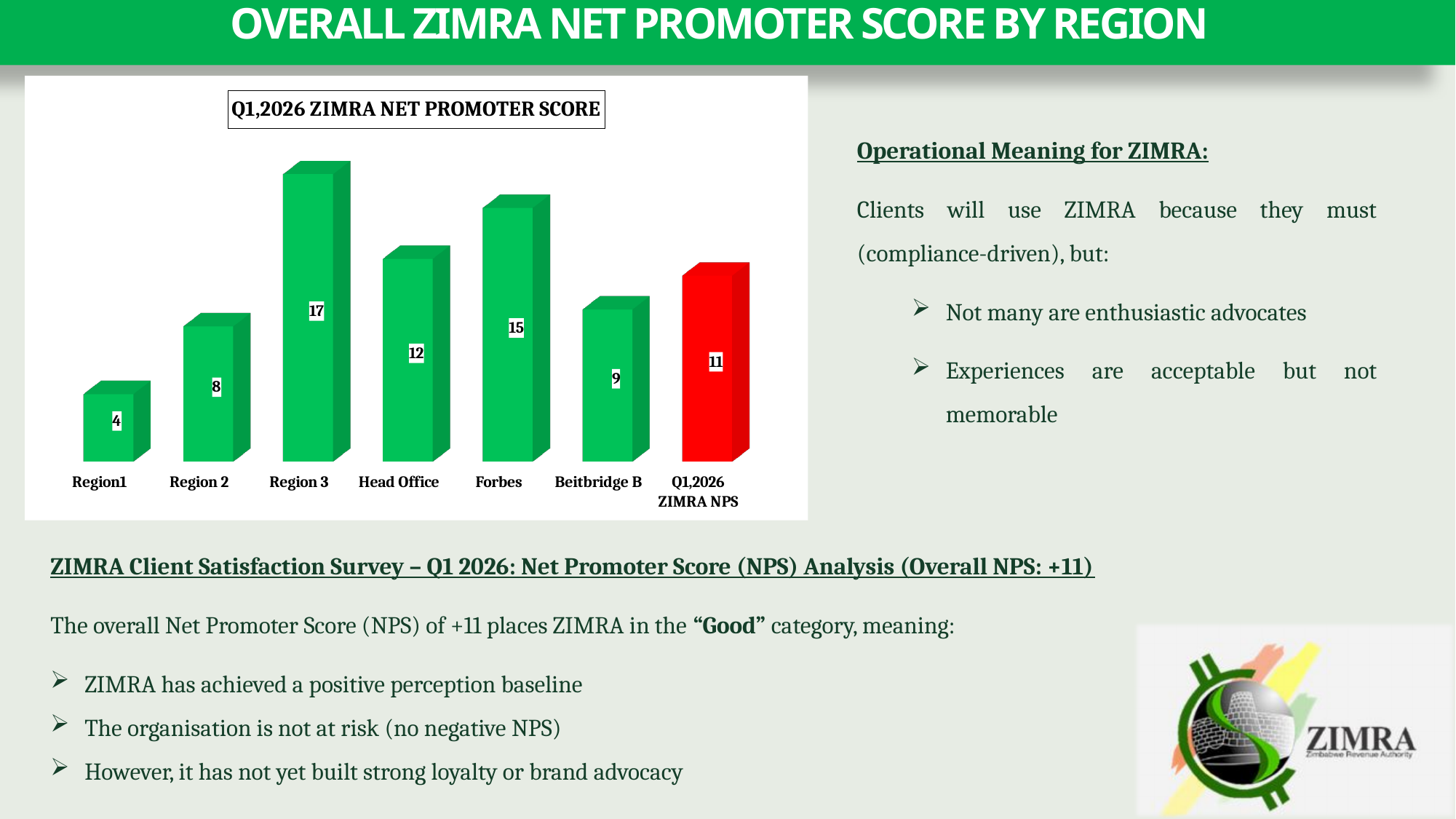
What is the difference between the scores for Forbes and Region 2? 7 What is the Net Promoter Score for Head Office? 12 What is the title of the chart? Q1,2026 ZIMRA NET PROMOTER SCORE Which category has the lowest Net Promoter Score? Region1 Which category has the highest Net Promoter Score? Region 3 Which bar in the chart is coloured red? Q1,2026 ZIMRA NPS How many bars are shown in the chart? 7 Which has a higher score, Head Office or Beitbridge B? Head Office What is the value of the Q1,2026 ZIMRA NPS bar? 11 What is the value shown for Beitbridge B? 9 What is the Net Promoter Score for Region 3? 17 What kind of chart is shown on the slide? Bar chart